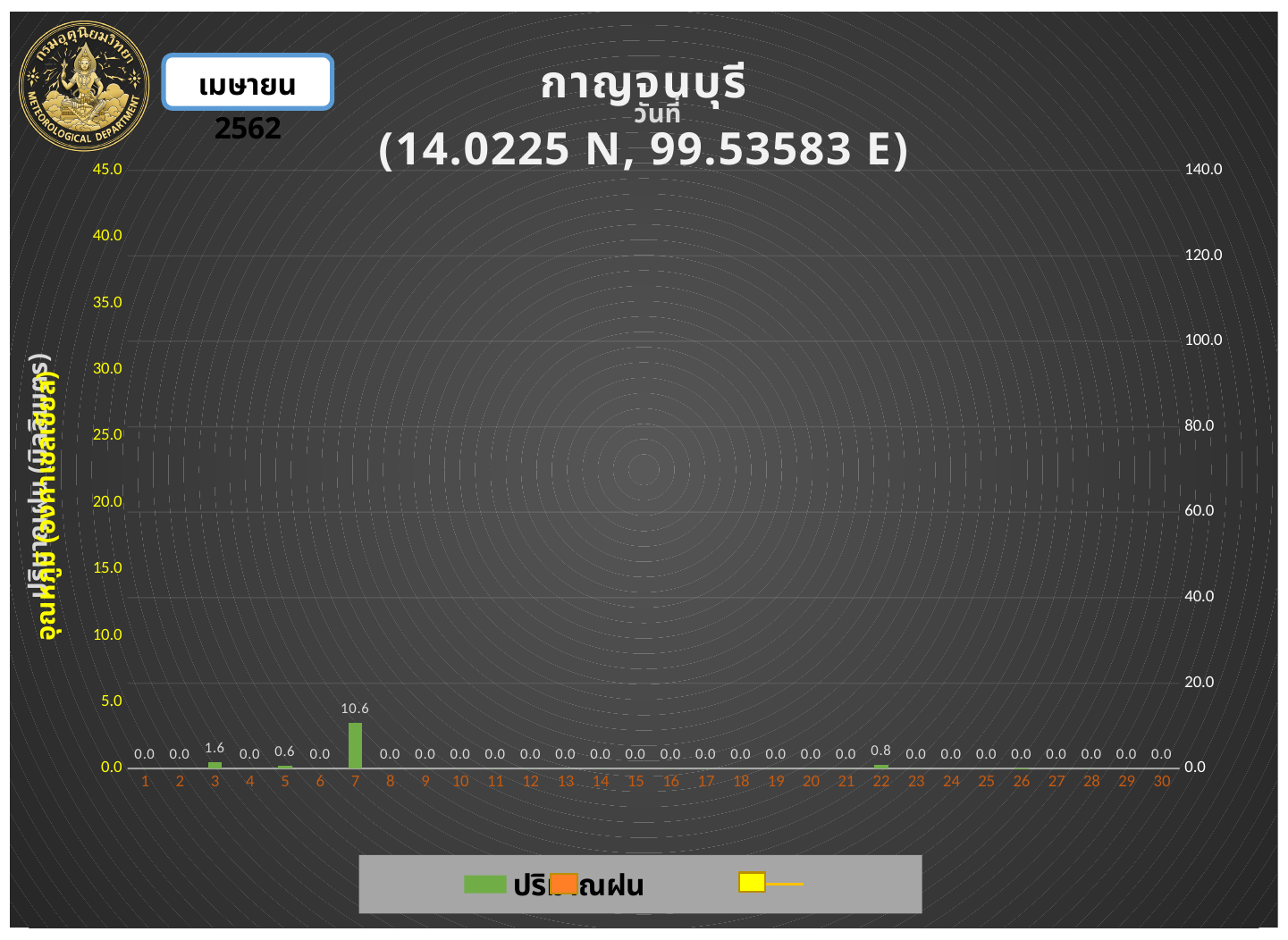
What is the value labelled for day 22? 0.8 Which has the larger value, day 3 or day 22? day 3 What is the value labelled for day 3? 1.6 What is the highest tick value on the left vertical axis? 45.0 What kind of chart is shown on the slide? bar chart How many days are shown along the x axis? 30 What is the value labelled for day 5? 0.6 What is the difference between the values for day 7 and day 3? 9.0 What is the rainfall value shown for day 7? 10.6 Which day has the highest bar in the chart? 7 What is the highest tick value on the right vertical axis? 140.0